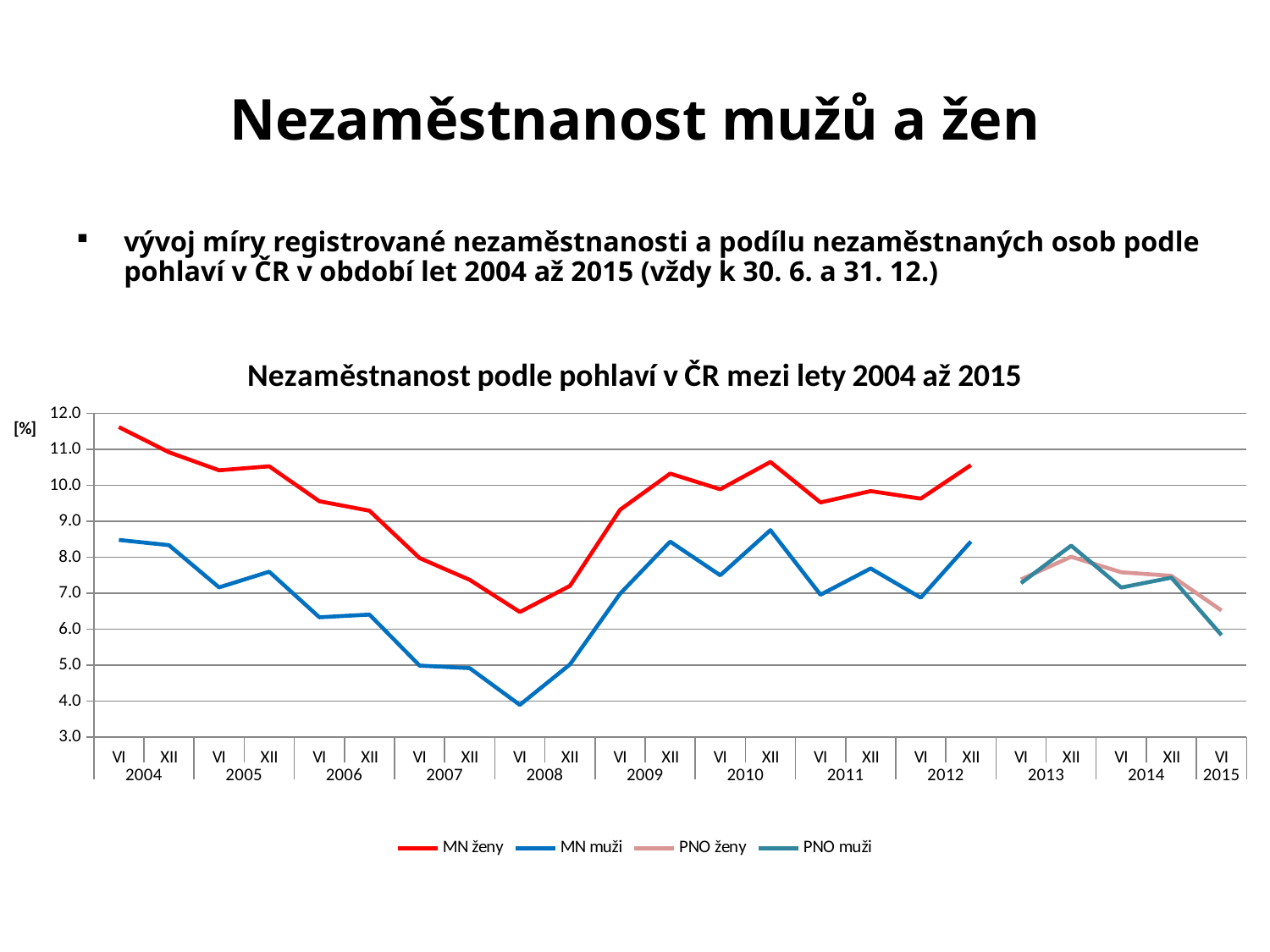
Is the value for MN ženy at VI 2004 greater or less than 11.0? greater Which series is drawn in red? MN ženy Does the MN muži series rise or fall between VI 2004 and VI 2008? fall How many series does the legend list? 4 What is the title of the chart? Nezaměstnanost podle pohlaví v ČR mezi lety 2004 až 2015 At which point does the MN muži series reach its lowest value? VI 2008 What kind of chart is shown on the slide? line chart Is the value for PNO muži at VI 2015 greater or less than 7.0? less At VI 2004, which series has the larger value, MN ženy or MN muži? MN ženy Is the value for MN muži at VI 2008 greater or less than 5.0? less At which point does the MN ženy series reach its highest value? VI 2004 How many years are labelled on the x axis? 12